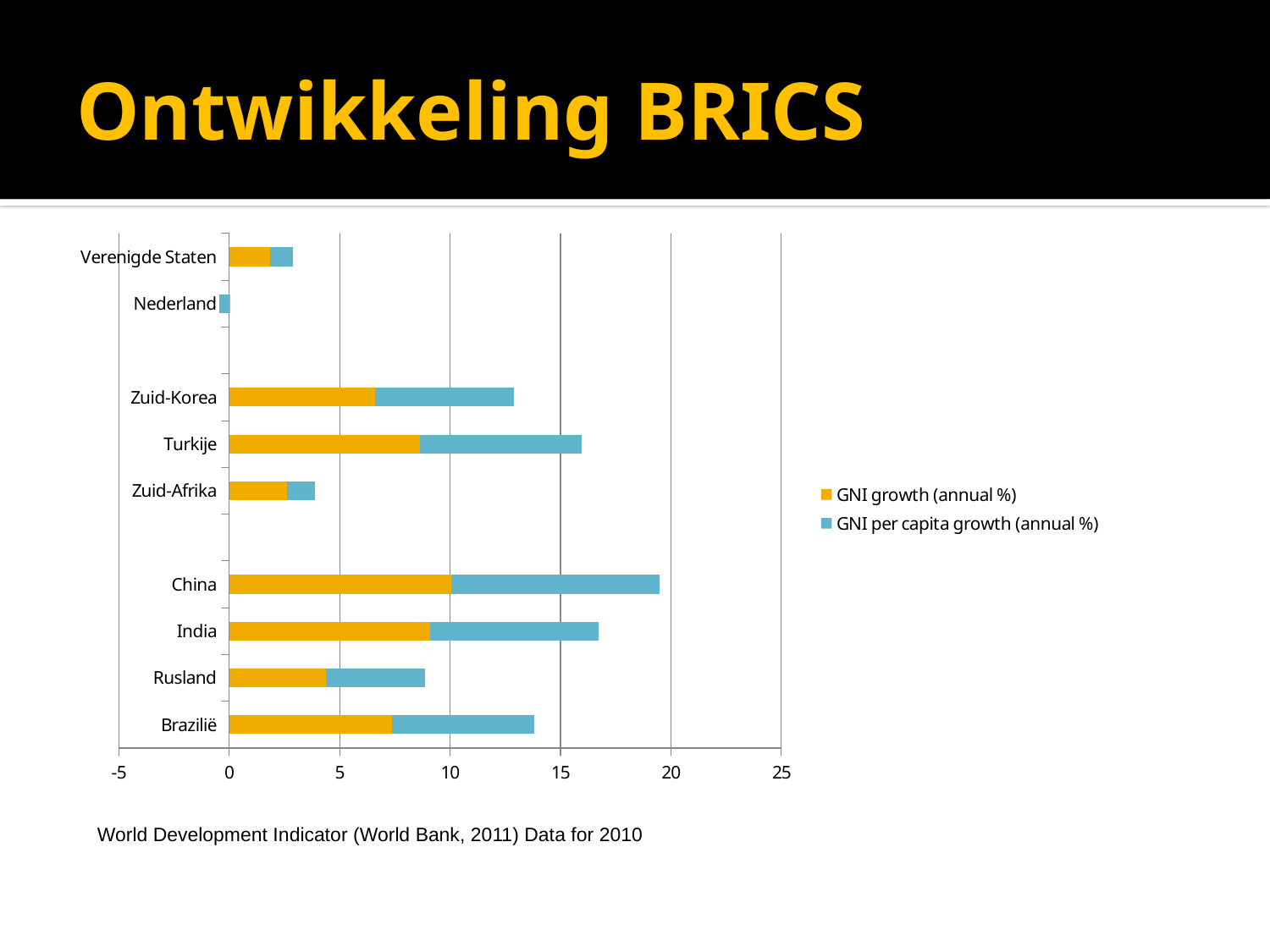
What kind of chart is shown on the slide? Stacked bar chart Is the total bar length for Zuid-Afrika greater or less than 5? less Which country has a longer total bar, Rusland or Brazilië? Brazilië Which country has the shortest total bar in the chart? Nederland What is the second entry listed in the chart legend? GNI per capita growth (annual %) Is the total bar length for China greater or less than 15? greater How many countries are labelled on the vertical axis of the chart? 9 Which country has the longest total bar in the chart? China How many series does the legend list? 2 Which country has a longer total bar, China or India? China Which series is shown in orange in the chart? GNI growth (annual %) Is the total bar length for Rusland greater or less than 10? less